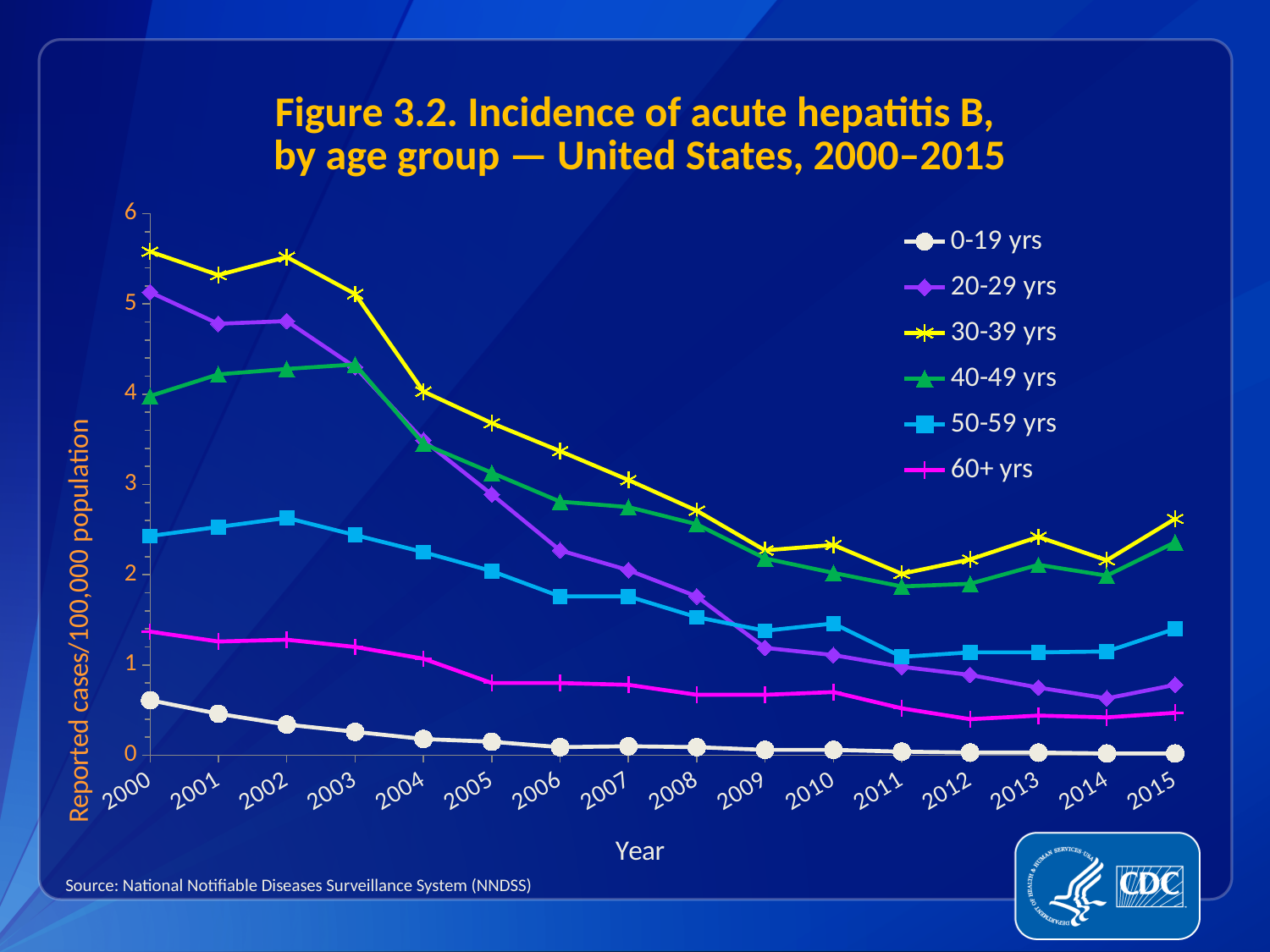
In 2000, which is larger: the value for 20-29 yrs or the value for 40-49 yrs? 20-29 yrs Does the incidence for 30-39 yrs rise or fall overall from 2000 to 2015? fall Which age group has the lowest incidence in 2015? 0-19 yrs What is the label of the y axis? Reported cases/100,000 population Is the value for 30-39 yrs in 2000 greater or less than 5? greater What kind of chart is shown on the slide? line chart How many years are plotted along the x axis? 16 Is the value for 20-29 yrs in 2015 greater or less than 1? less How many age groups does the legend list? 6 Which age group has the highest incidence in 2015? 30-39 yrs Is the value for 40-49 yrs in 2011 greater or less than 2? less Which age group has the highest incidence in 2000? 30-39 yrs